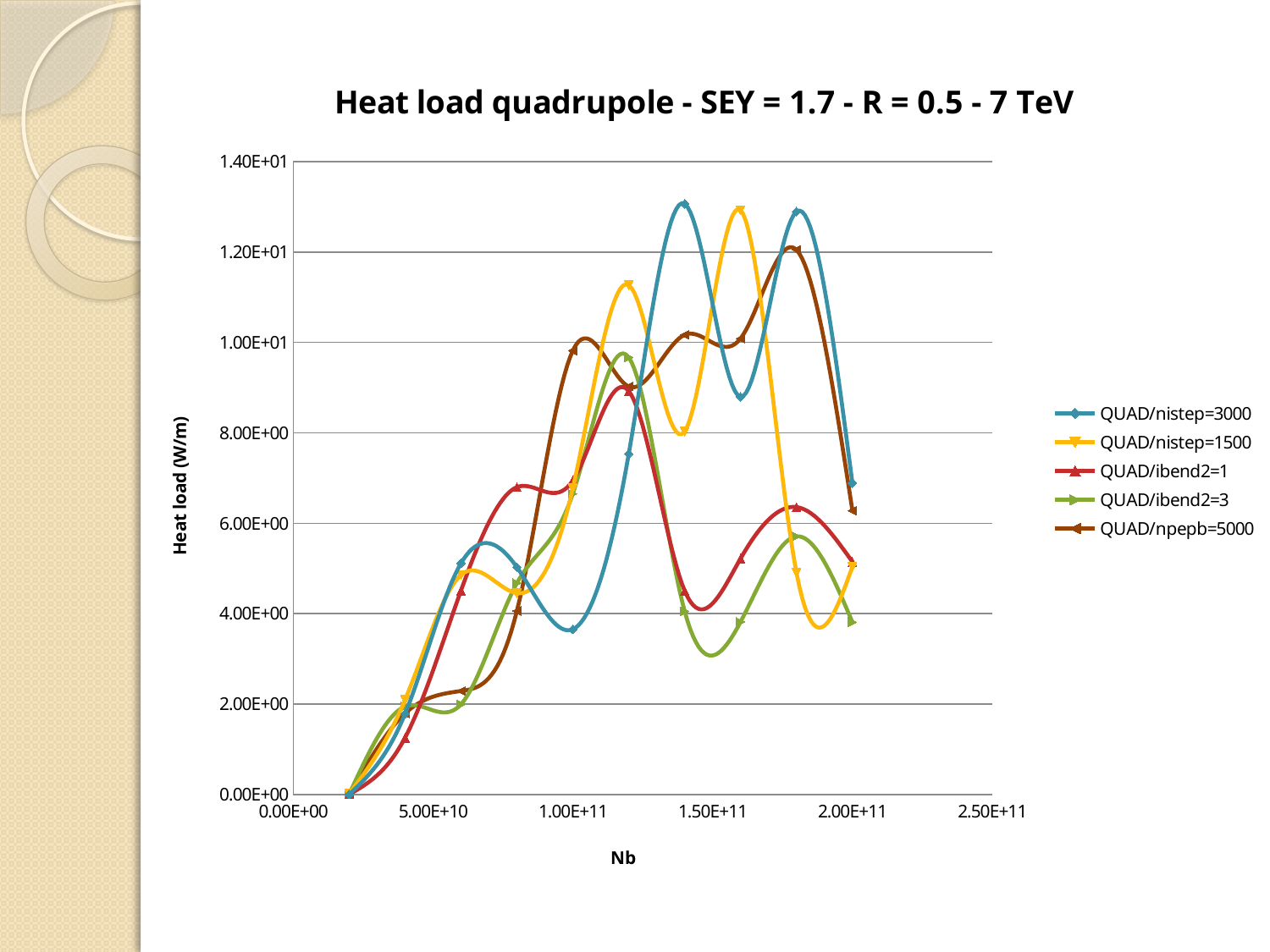
Is the peak value of QUAD/nistep=3000 near Nb = 1.40E+11 greater or less than 1.20E+01? greater At Nb = 1.40E+11, which series has the larger value: QUAD/nistep=3000 or QUAD/ibend2=3? QUAD/nistep=3000 What is the label of the vertical axis? Heat load (W/m) How many series does the legend list? 5 Is the value of QUAD/ibend2=1 near Nb = 8.00E+10 greater or less than 6.00E+00? greater What kind of chart is shown on the slide? line chart At Nb = 1.00E+11, which series has the larger value: QUAD/npepb=5000 or QUAD/nistep=3000? QUAD/npepb=5000 What is the title of the chart? Heat load quadrupole - SEY = 1.7 - R = 0.5 - 7 TeV Is the lowest value of QUAD/ibend2=3 near Nb = 1.50E+11 greater or less than 4.00E+00? less Does the QUAD/ibend2=3 series rise or fall between Nb = 1.20E+11 and Nb = 1.50E+11? fall